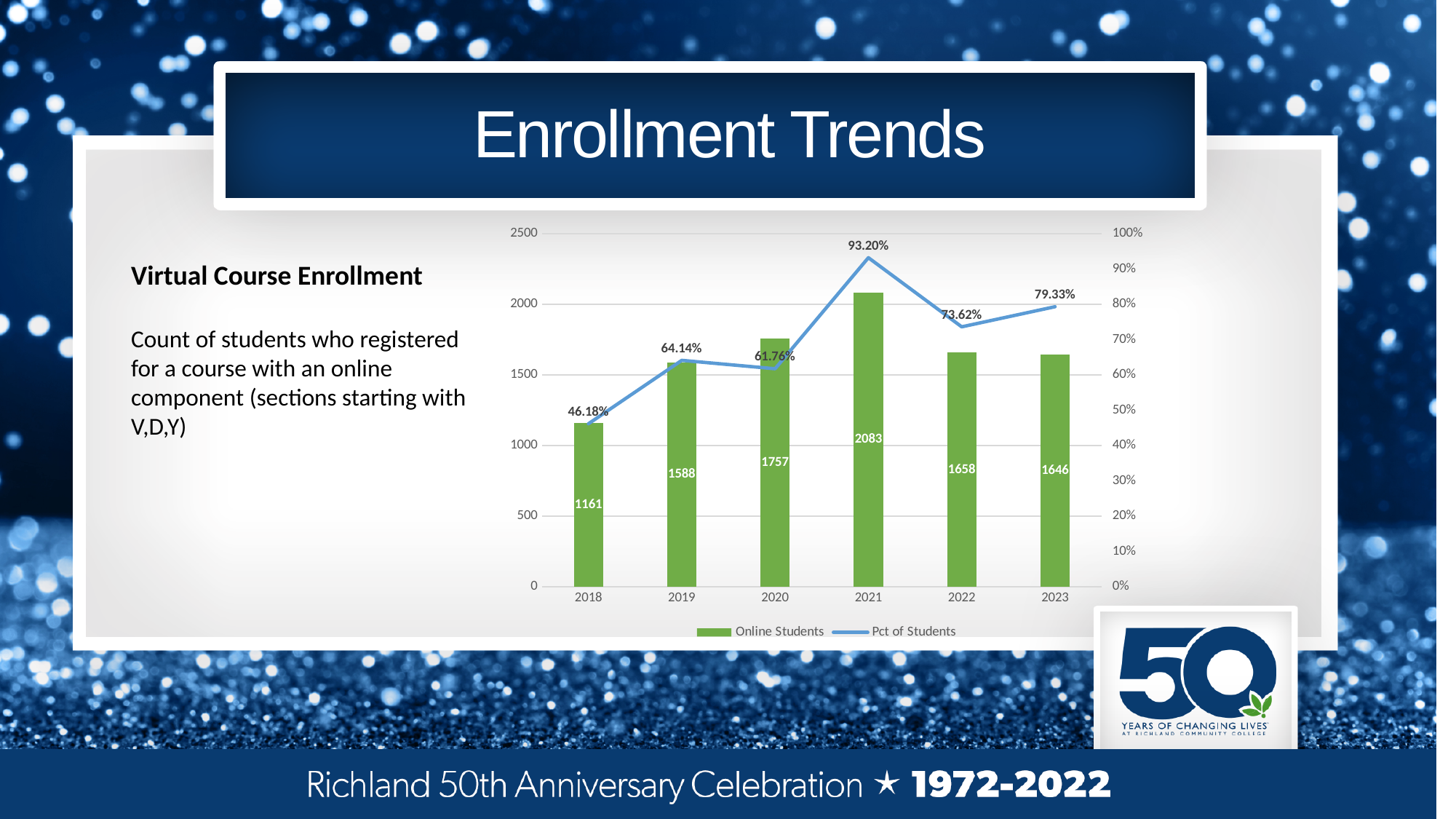
Which year has more Online Students, 2019 or 2022? 2022 Which year has the lowest Pct of Students? 2018 Which year has the highest number of Online Students? 2021 What is the number of Online Students in 2023? 1646 What is the number of Online Students in 2021? 2083 What kind of chart is used for the Online Students series? bar chart Does the Pct of Students line rise or fall from 2021 to 2022? fall What is the difference in Online Students between 2021 and 2020? 326 How many years are shown on the x axis? 6 How many series does the legend list? 2 What is the Pct of Students value for 2018? 46.18% Is the number of Online Students in 2018 greater or less than 1000? greater